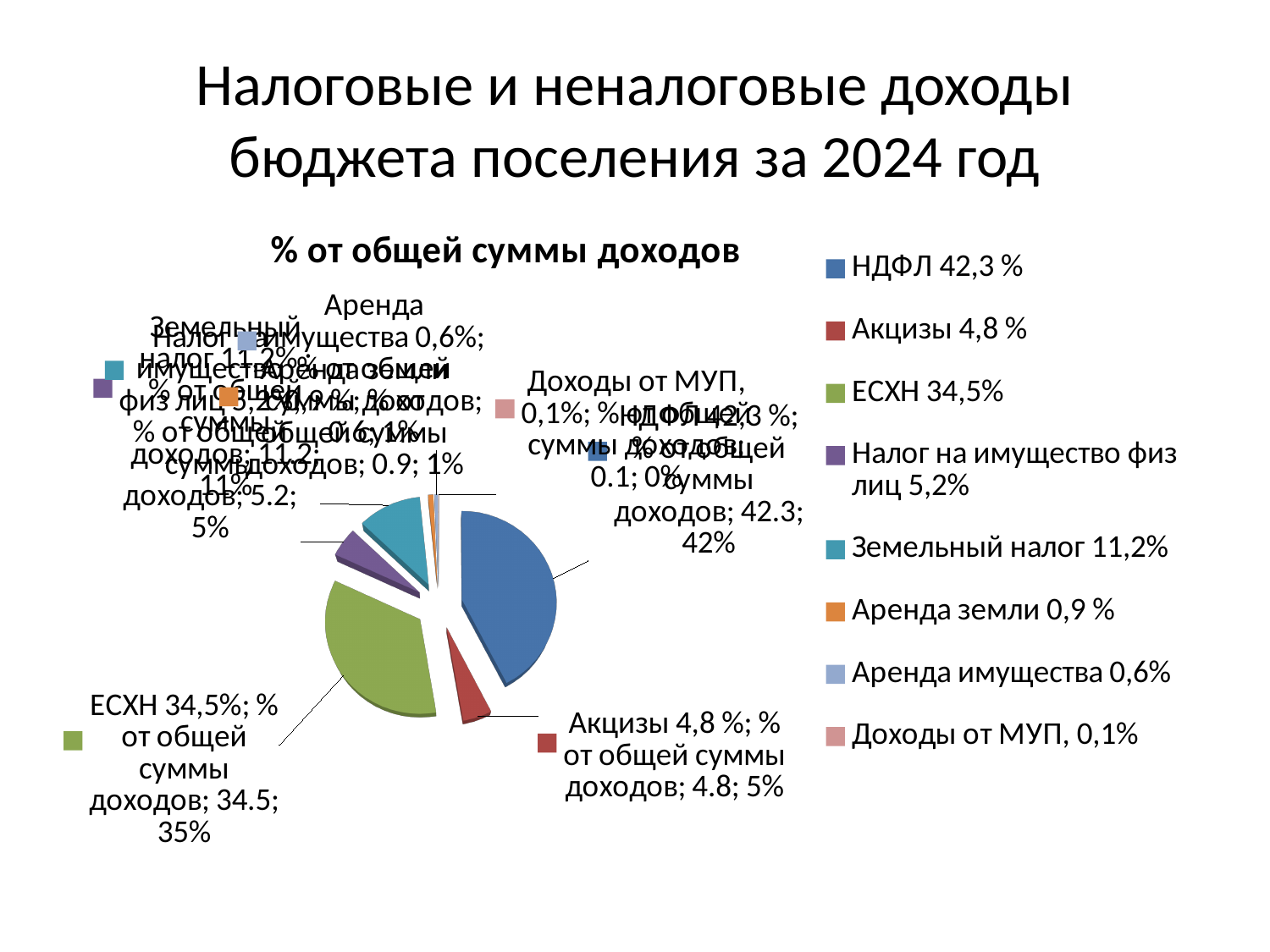
How many categories does the legend of the pie chart list? 8 What kind of chart is shown on the slide? pie chart Which category has the smallest share of the pie? Доходы от МУП What share of total income does Аренда имущества account for, according to the legend? 0,6% What is the title of the pie chart? % от общей суммы доходов What share of total income do Акцизы account for, according to the legend? 4,8 % What share of total income does ЕСХН account for, according to the legend? 34,5% Which is larger: the share of Налог на имущество физ лиц or the share of Акцизы? Налог на имущество физ лиц What is the difference in percentage points between the share of Аренда земли and the share of Аренда имущества? 0,3 What share of total income does Земельный налог account for, according to the legend? 11,2% Which category has the largest share of the pie? НДФЛ What is the difference in percentage points between the share of НДФЛ and the share of ЕСХН? 7,8